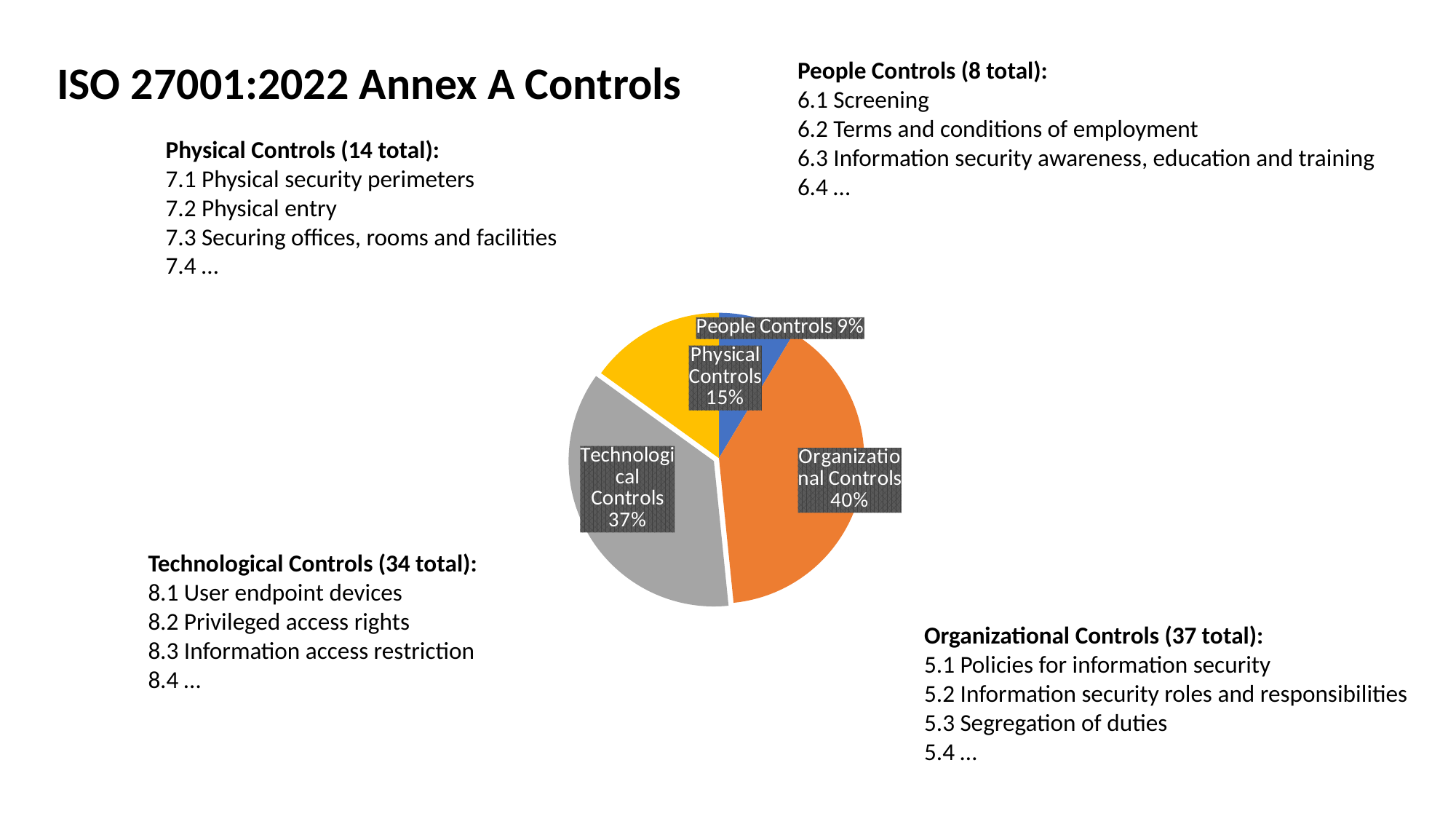
Which category has the largest slice of the pie? Organizational Controls What share of the pie does Organizational Controls represent? 40% Which is larger, the Physical Controls slice or the People Controls slice? Physical Controls How many slices does the pie chart have? 4 What is the difference in percentage points between Organizational Controls and Technological Controls? 3 What share of the pie does Physical Controls represent? 15% What share of the pie does Technological Controls represent? 37% What kind of chart is shown on the slide? pie chart Which category has the smallest slice of the pie? People Controls What is the difference in percentage points between Physical Controls and People Controls? 6 What colour is the Organizational Controls slice? orange